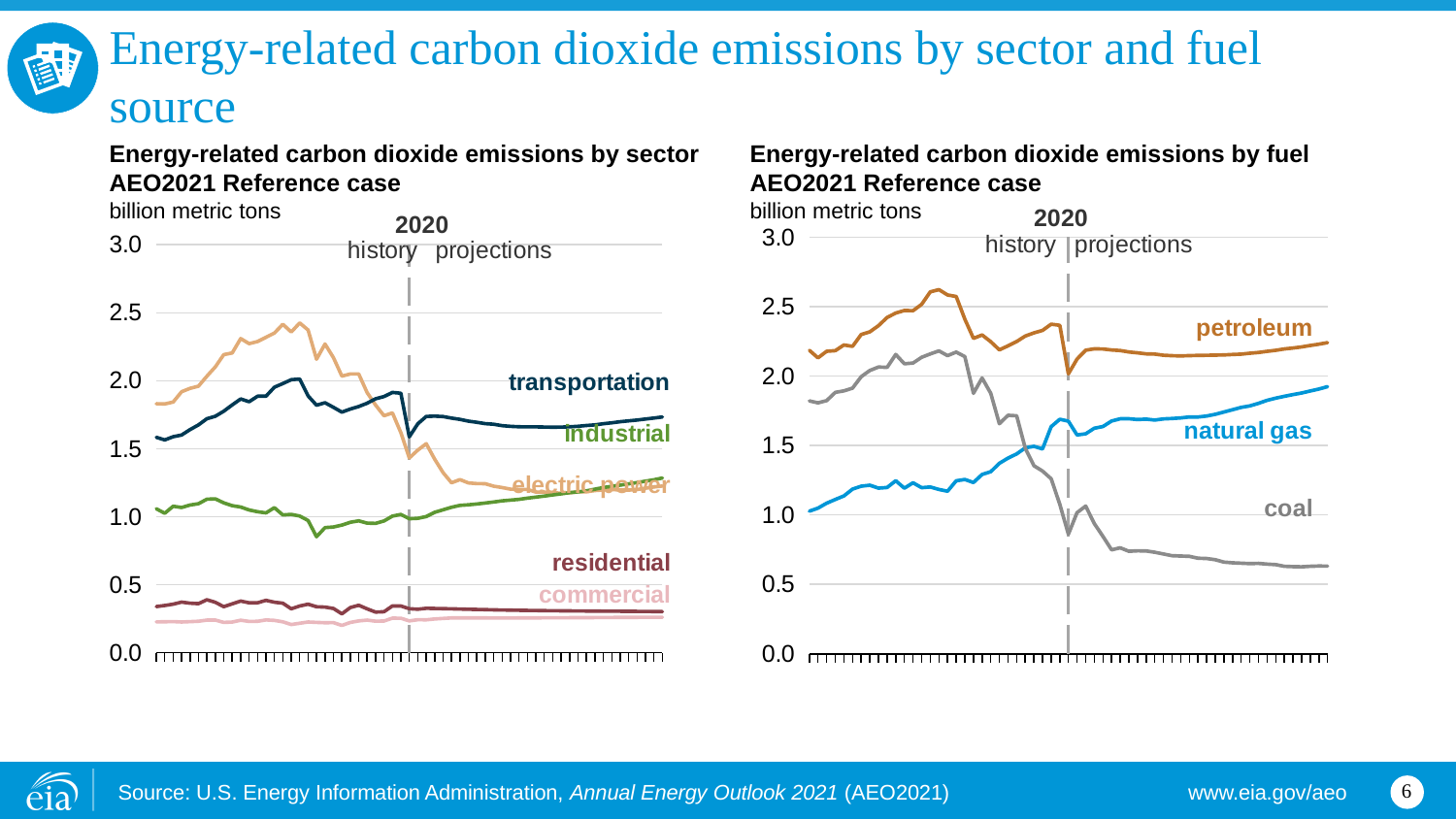
How many sector series are plotted on the left chart, 'Energy-related carbon dioxide emissions by sector'? 5 On the left chart, 'Energy-related carbon dioxide emissions by sector', is the peak value for electric power greater or less than 2.0? greater How many fuel series are plotted on the right chart, 'Energy-related carbon dioxide emissions by fuel'? 3 What kind of chart is the 'Energy-related carbon dioxide emissions by sector' chart on the left? line chart On the right chart, 'Energy-related carbon dioxide emissions by fuel', which is larger at the end of the projection period, petroleum or natural gas? petroleum On the right chart, 'Energy-related carbon dioxide emissions by fuel', is the value for coal at the end of the projection period greater or less than 1.0? less On the right chart, 'Energy-related carbon dioxide emissions by fuel', is the value for natural gas at the end of the projection period greater or less than 1.5? greater On the right chart, 'Energy-related carbon dioxide emissions by fuel', do coal emissions rise or fall over the projection period? fall What unit is used on the y axis of both charts? billion metric tons On the left chart, 'Energy-related carbon dioxide emissions by sector', which is larger, residential or commercial? residential On the right chart, 'Energy-related carbon dioxide emissions by fuel', which fuel has the highest emissions at the end of the projection period? petroleum On the left chart, 'Energy-related carbon dioxide emissions by sector', which sector has the lowest emissions throughout the chart? commercial